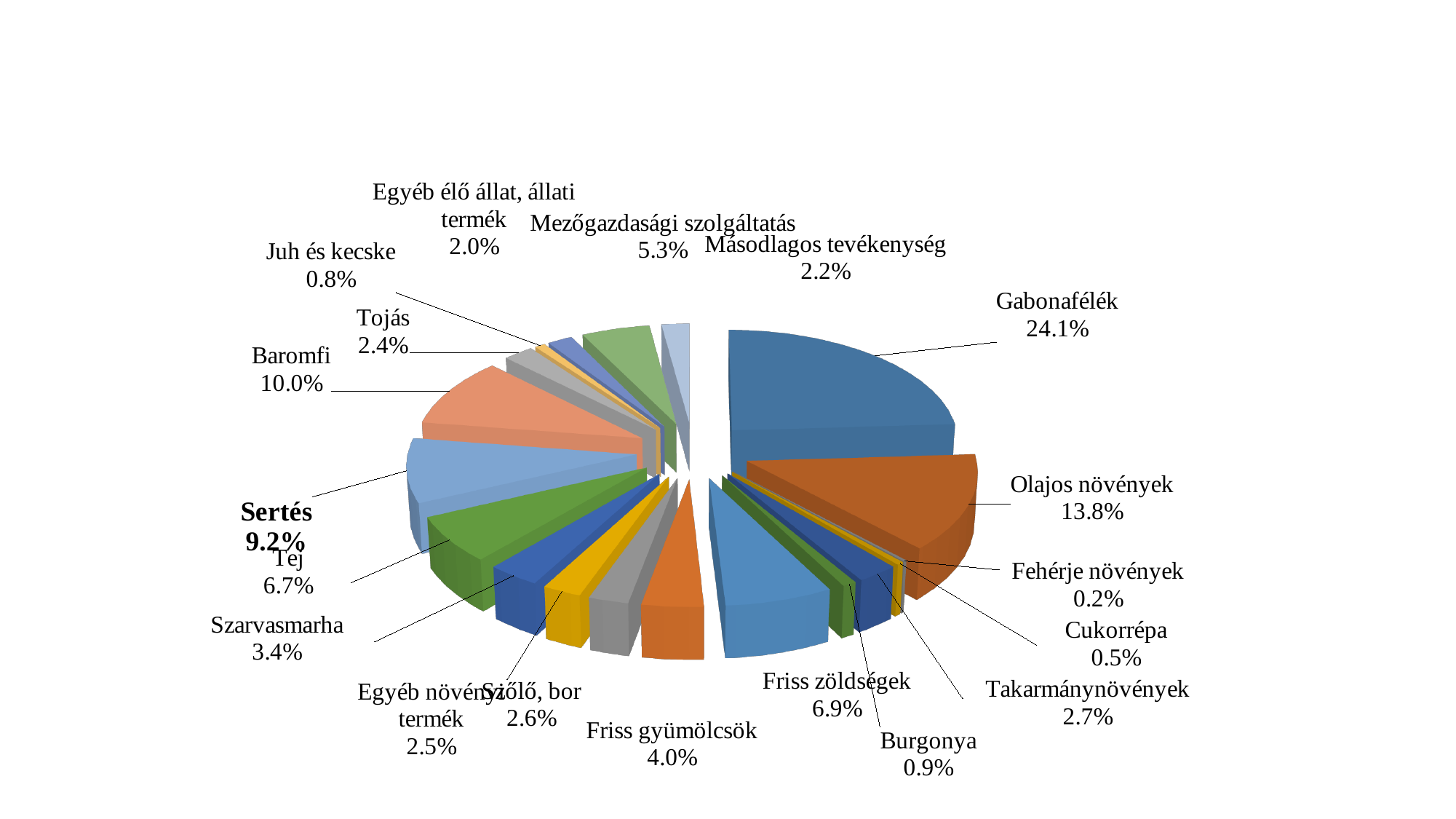
What is the value shown for Mezőgazdasági szolgáltatás? 5.3% Which is larger, the share for Tej or the share for Friss zöldségek? Friss zöldségek What is the value shown for Baromfi? 10.0% How many categories are shown in the pie chart? 19 Which category has the smallest slice of the pie? Fehérje növények What kind of chart is shown on the slide? Pie chart What is the difference between the shares of Gabonafélék and Olajos növények? 10.3% What share of the pie does Gabonafélék have? 24.1% What percentage is labelled for Sertés? 9.2% What is the difference between the values for Baromfi and Sertés? 0.8% Which category has the largest slice of the pie? Gabonafélék What is the value for Fehérje növények? 0.2%